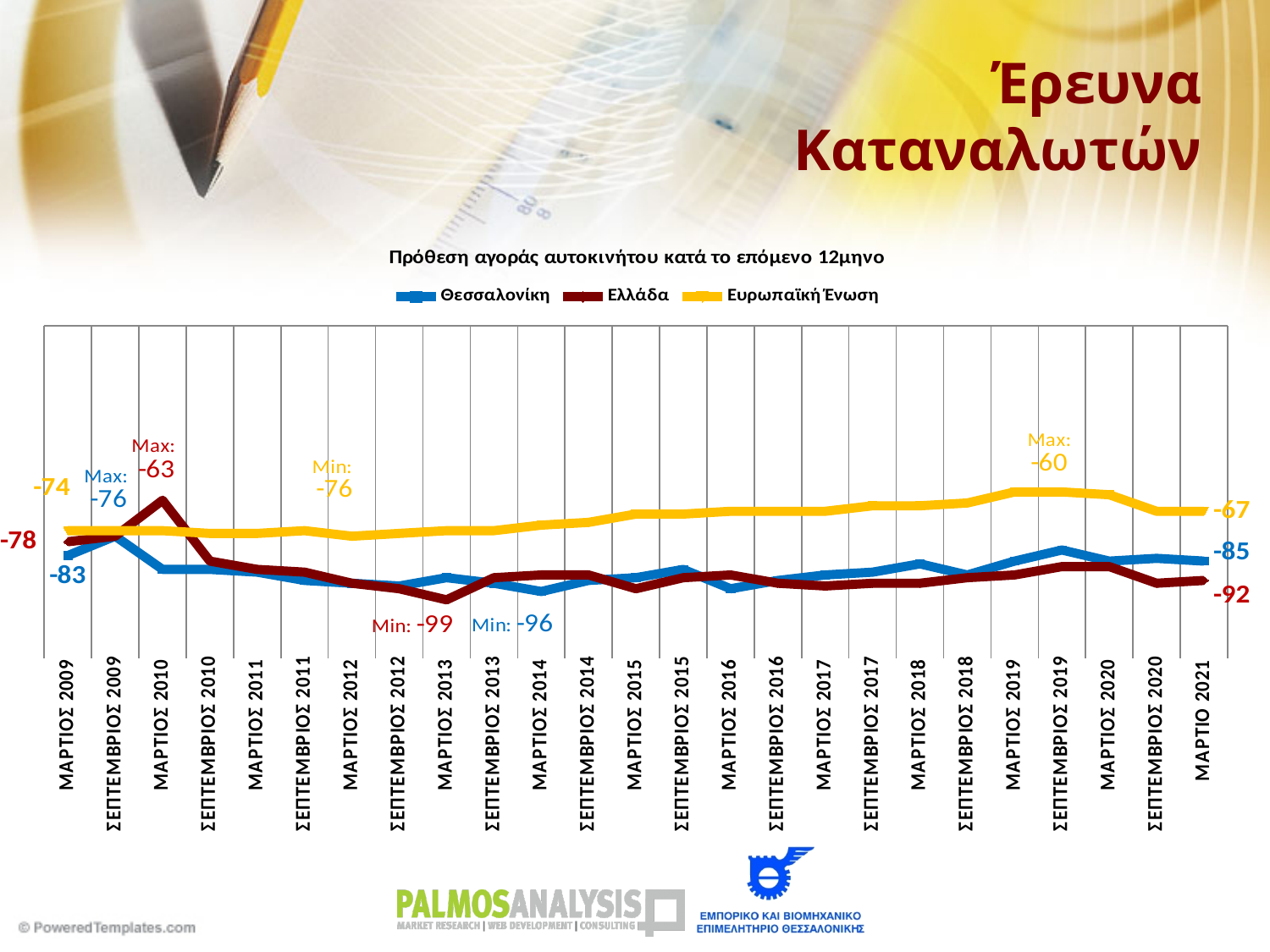
What is the value for Ελλάδα in ΜΑΡΤΙΟ 2021? -92 What is the minimum value of the Θεσσαλονίκη series? -96 What is the value for Ευρωπαϊκή Ένωση in ΜΑΡΤΙΟ 2021? -67 How many series does the legend list? 3 What kind of chart is shown on the slide? line chart Which series has the higher value in ΜΑΡΤΙΟ 2021, Θεσσαλονίκη or Ελλάδα? Θεσσαλονίκη What is the difference between the Ευρωπαϊκή Ένωση value and the Ελλάδα value in ΜΑΡΤΙΟ 2021? 25 What is the value for Θεσσαλονίκη in ΜΑΡΤΙΟΣ 2009? -83 What is the title of the chart? Πρόθεση αγοράς αυτοκινήτου κατά το επόμενο 12μηνο How many time periods are shown on the x axis? 25 What is the maximum value of the Ελλάδα series, and in which period does it occur? -63, ΜΑΡΤΙΟΣ 2010 In which period does the Ευρωπαϊκή Ένωση series reach its maximum of -60? ΜΑΡΤΙΟΣ 2019